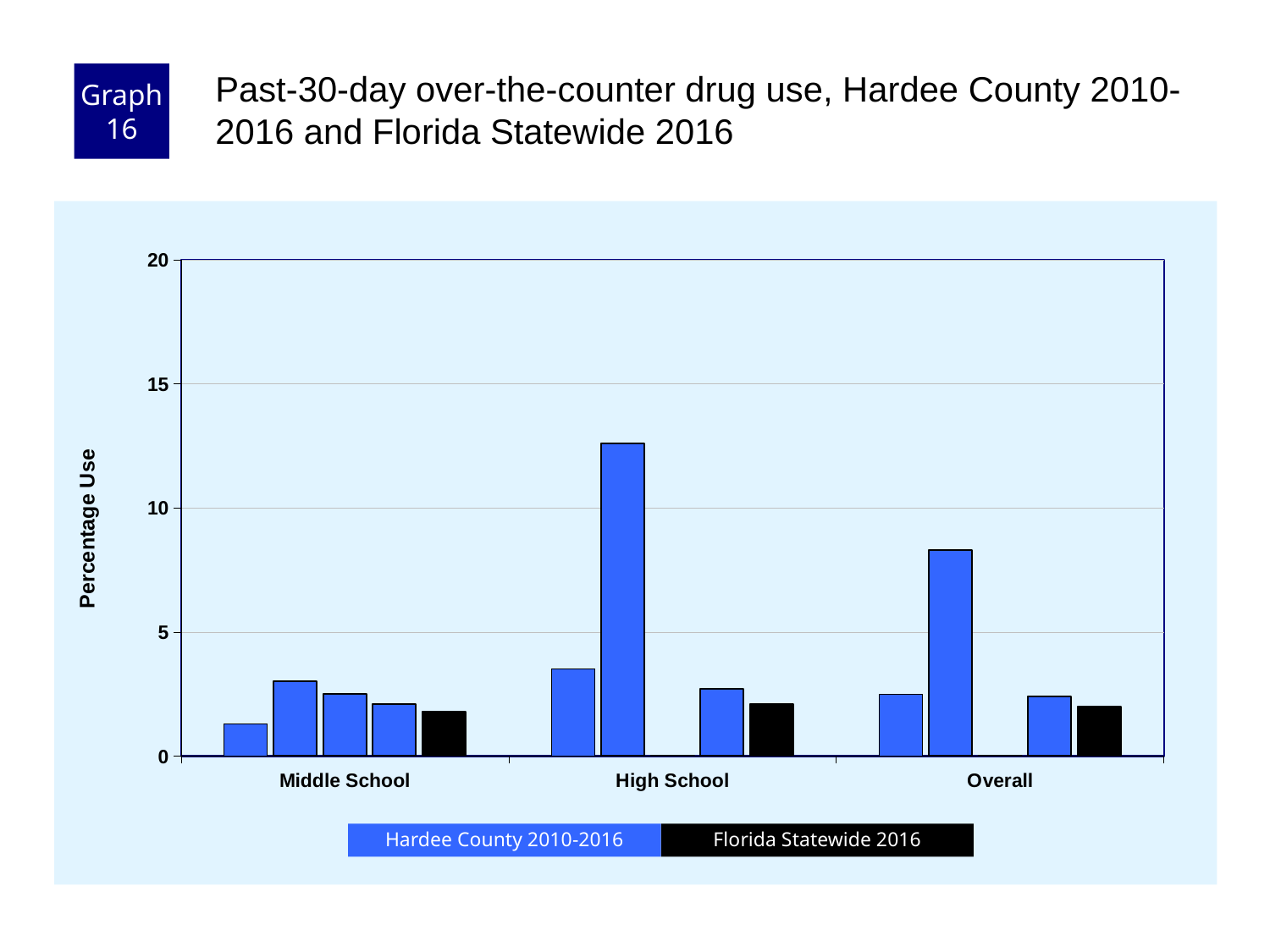
Is the Florida Statewide 2016 value for High School greater or less than 5? less Which category contains the tallest bar in the chart? High School How many categories are shown on the x axis of the chart? 3 Is the tallest Hardee County 2010-2016 bar for High School greater or less than 10? greater How many series does the chart legend list? 2 What is the label on the vertical axis of the chart? Percentage Use Is the Florida Statewide 2016 value for Middle School greater or less than 5? less Which is larger: the tallest Hardee County 2010-2016 bar for High School or the tallest Hardee County 2010-2016 bar for Overall? High School What kind of chart is shown on the slide? bar chart Which series is shown in black in the chart legend? Florida Statewide 2016